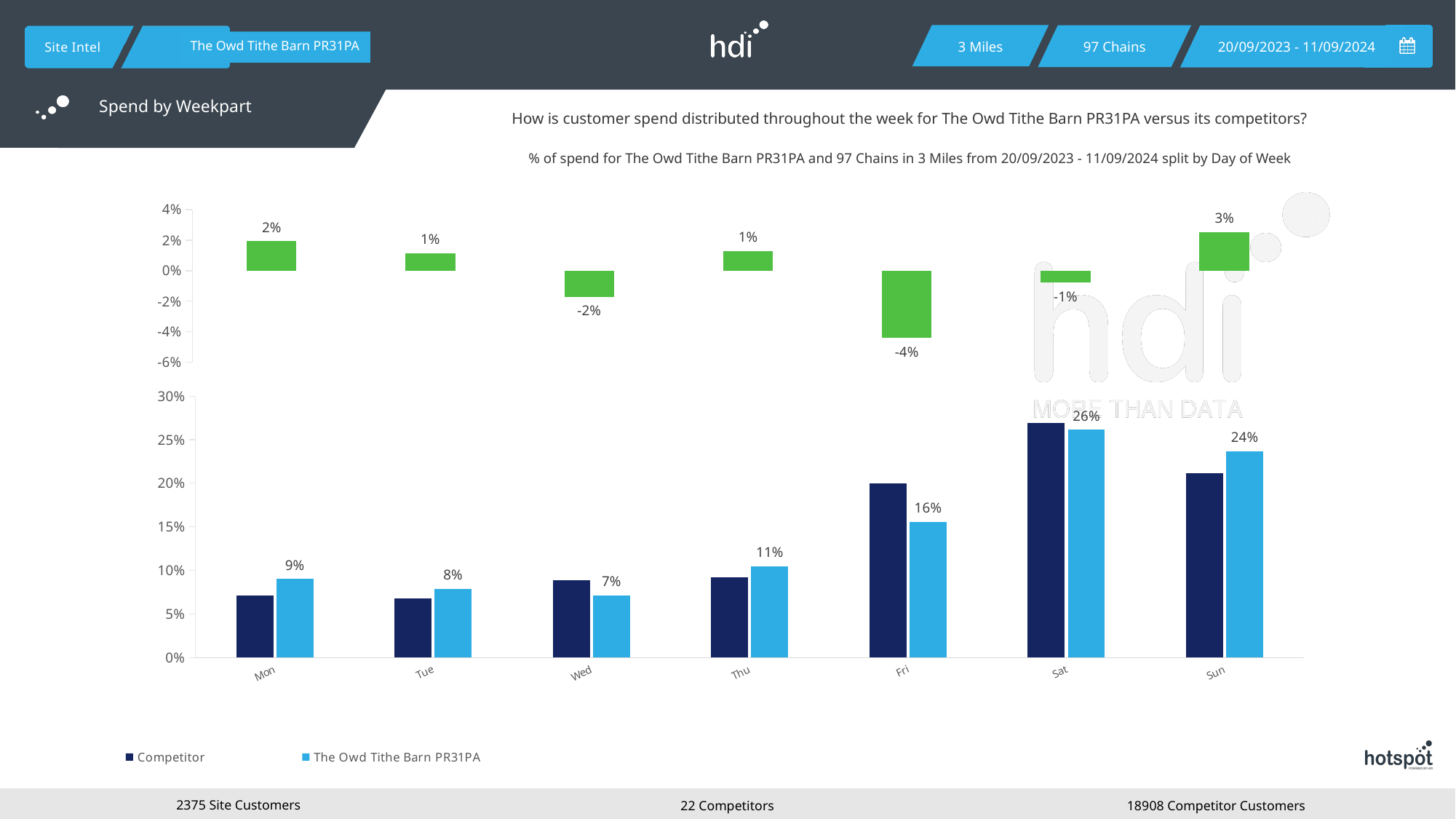
In the bottom bar chart, is the Competitor value for Fri greater or less than 15%? greater What type of chart is the bottom chart? Bar chart How many days of the week are shown on the x axis of the bottom bar chart? 7 In the top chart of green bars, what is the value for Sun? 3% In the bottom bar chart, which is larger on Wed: the Competitor bar or The Owd Tithe Barn PR31PA bar? Competitor In the bottom bar chart, what is the value for The Owd Tithe Barn PR31PA on Thu? 11% In the top chart of green bars, which day has the lowest value? Fri In the bottom bar chart, what is the difference between The Owd Tithe Barn PR31PA values for Sat and Sun? 2% In the top chart of green bars, what is the value for Fri? -4% How many series does the legend of the bottom chart list? 2 In the bottom bar chart, what is the value for The Owd Tithe Barn PR31PA on Sat? 26% In the bottom bar chart, which day has the highest value for The Owd Tithe Barn PR31PA? Sat